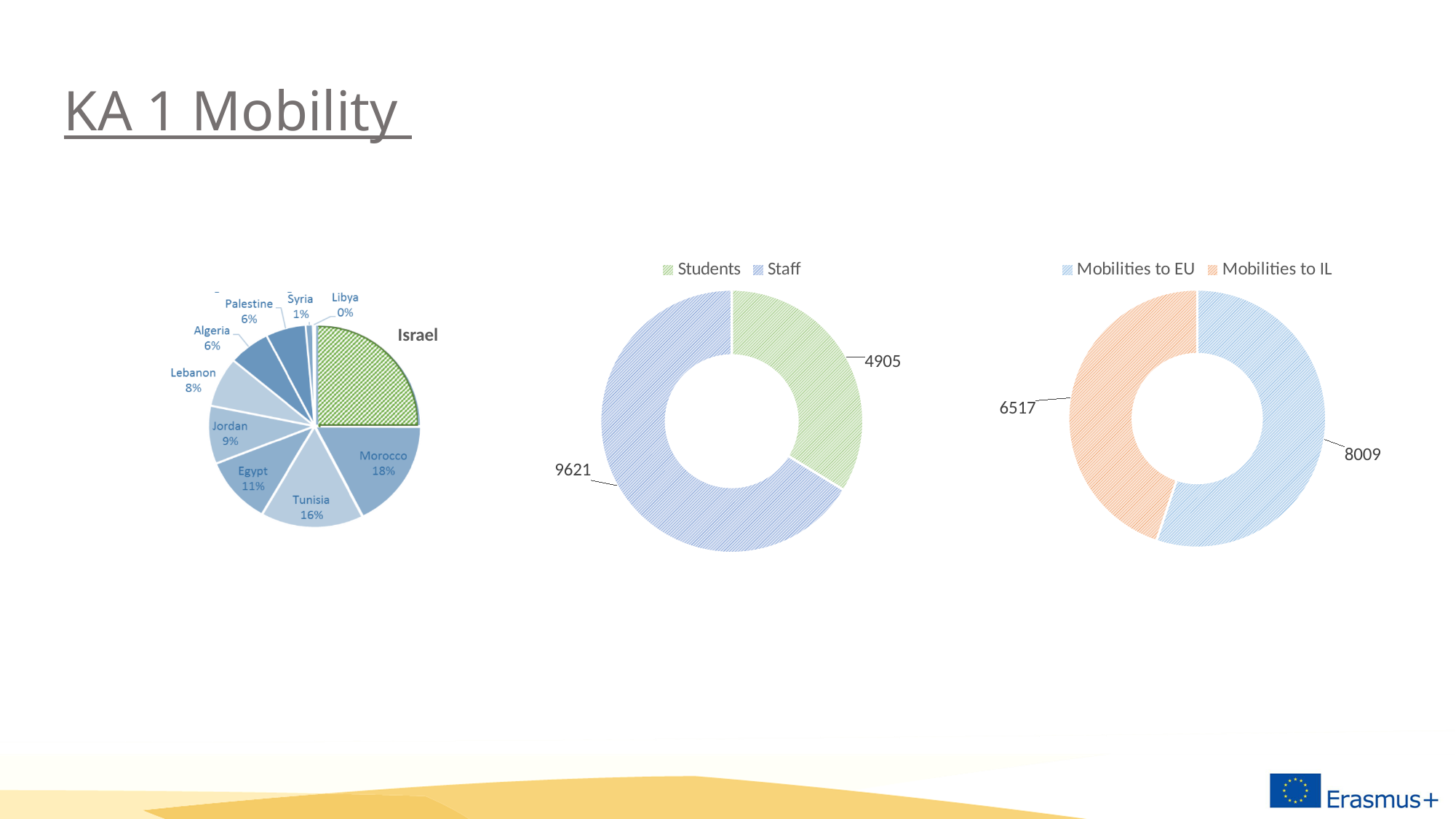
On the left pie chart, which is larger, Egypt or Jordan? Egypt On the left pie chart, what share does Morocco have? 18% On the middle doughnut chart, what is the difference between the Staff and Students values? 4716 On the middle doughnut chart, which is larger, Students or Staff? Staff On the middle doughnut chart, what is the value for Staff? 9621 On the right doughnut chart, how many series does the legend list? 2 On the right doughnut chart, what is the value for Mobilities to EU? 8009 On the right doughnut chart, what is the difference between Mobilities to EU and Mobilities to IL? 1492 On the left pie chart, which country has the largest slice? Israel On the middle doughnut chart, what is the value for Students? 4905 On the right doughnut chart, what is the value for Mobilities to IL? 6517 On the middle doughnut chart, what is the total of Students and Staff? 14526